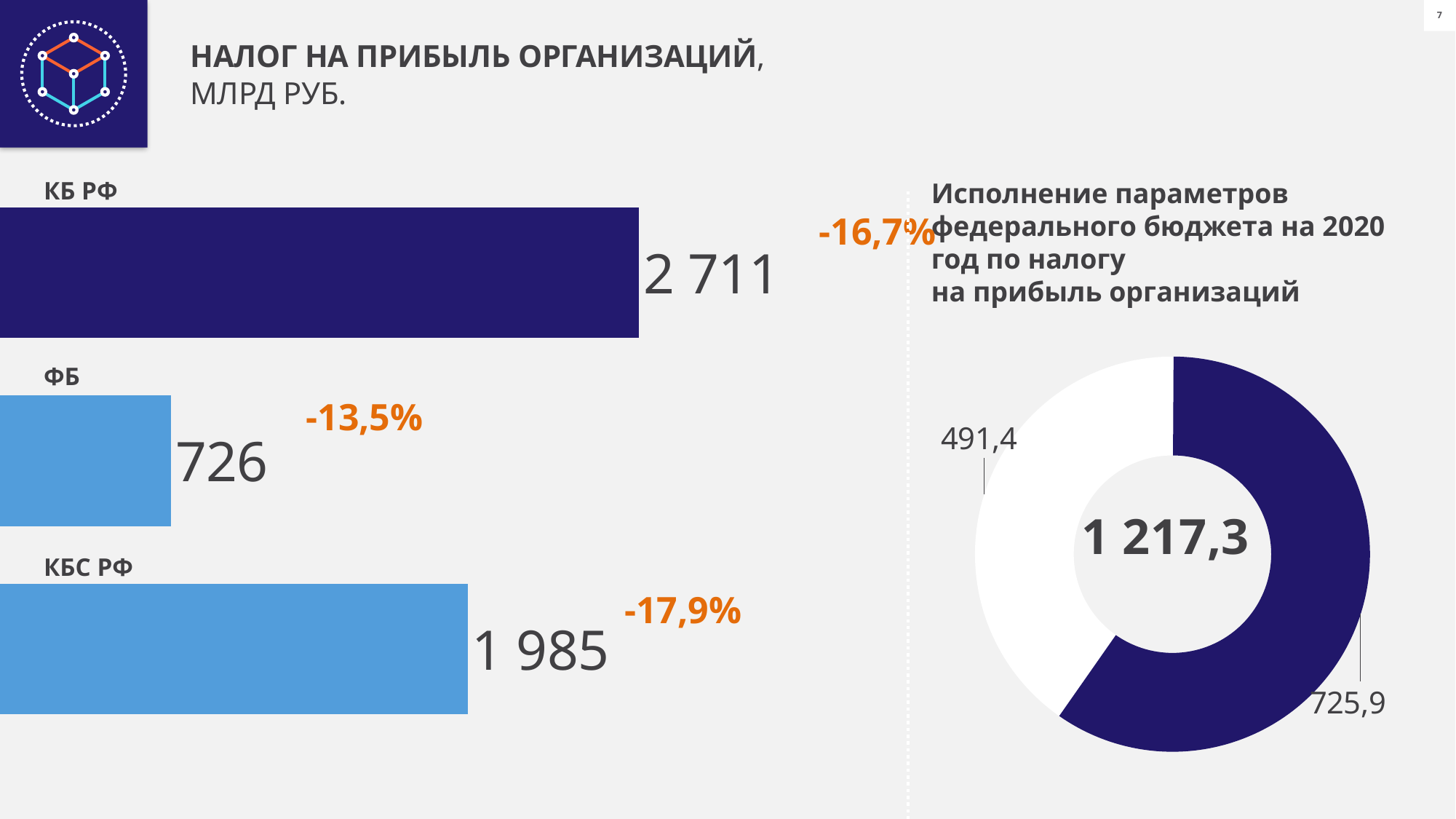
On the bar chart on the left, what percentage change is shown next to the ФБ bar? -13,5% On the donut chart on the right, what is the value of the dark blue segment? 725,9 What kind of chart is shown on the left of the slide? Bar chart On the bar chart on the left, what is the value for КБ РФ? 2 711 On the donut chart on the right, what total is shown in the centre? 1 217,3 On the bar chart on the left, which is larger, the value for КБС РФ or the value for ФБ? КБС РФ On the bar chart on the left, what is the value for ФБ? 726 On the bar chart on the left, what is the value for КБС РФ? 1 985 On the bar chart on the left, which category has the lowest value? ФБ On the bar chart on the left, which category has the highest value? КБ РФ On the bar chart on the left, how many categories are shown? 3 On the bar chart on the left, what is the difference between the values for КБ РФ and КБС РФ? 726